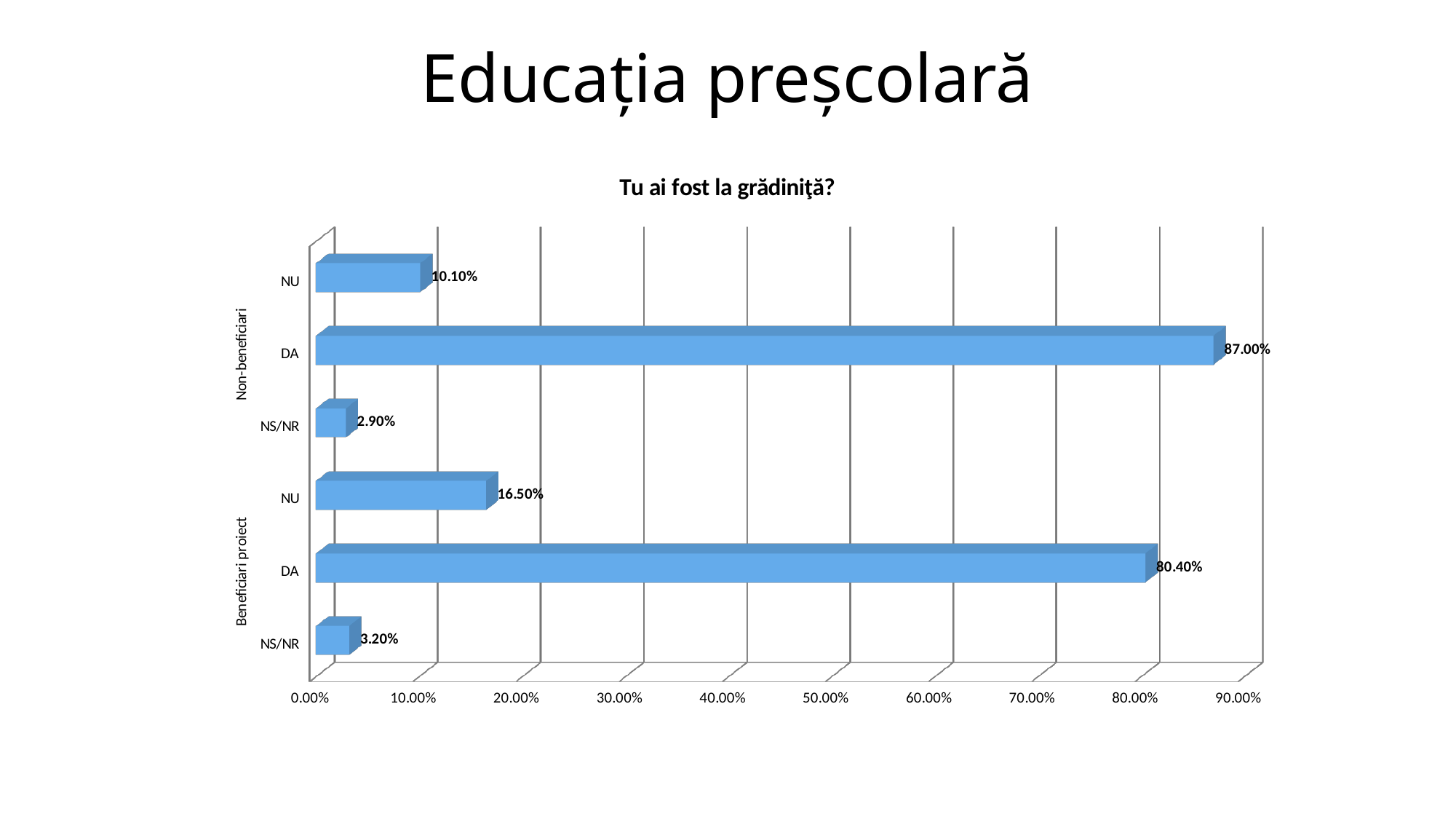
Is the value for DA among Beneficiari proiect greater or less than 70.00%? greater Which bar has the highest value on the chart? DA (Non-beneficiari) What is the value for NS/NR among Beneficiari proiect? 3.20% Which is larger: the NU value for Beneficiari proiect or the NU value for Non-beneficiari? NU for Beneficiari proiect What is the value for NU among Beneficiari proiect? 16.50% How many bars are plotted on the chart? 6 What is the difference between the DA value for Non-beneficiari and the DA value for Beneficiari proiect? 6.60% Which bar has the lowest value on the chart? NS/NR (Non-beneficiari) What kind of chart is shown on the slide? Bar chart What is the value for NU among Non-beneficiari? 10.10% What is the title of the chart? Tu ai fost la grădiniţă? What is the value for DA among Non-beneficiari? 87.00%